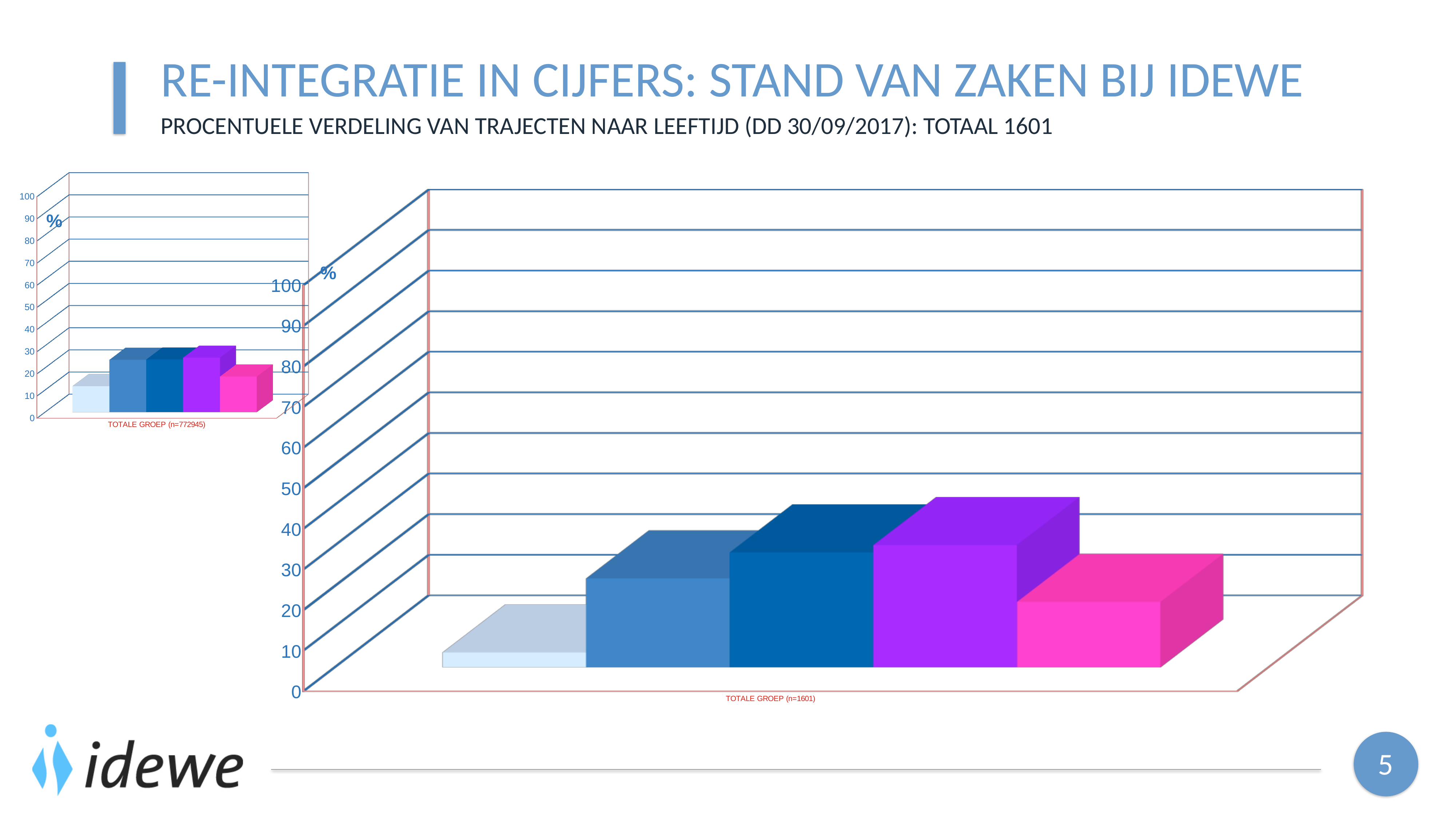
In the large chart (n=1601), is the value of the pink bar greater or less than 30? less In the large chart (n=1601), which is larger: the medium blue second bar or the pink fifth bar? the medium blue second bar How many bars are plotted in the small chart labelled TOTALE GROEP (n=772945)? 5 In the large chart (n=1601), which bar is the lowest? the light blue bar (first bar) In the small chart (n=772945), is the value of the purple bar greater or less than 20? greater How many bars are plotted in the large chart labelled TOTALE GROEP (n=1601)? 5 In the large chart (n=1601), is the value of the light blue first bar greater or less than 10? less What kind of chart is the large chart on the right of the slide? bar chart What is the highest value shown on the y axis of the large chart? 100 What is the category label on the x axis of the large chart? TOTALE GROEP (n=1601)